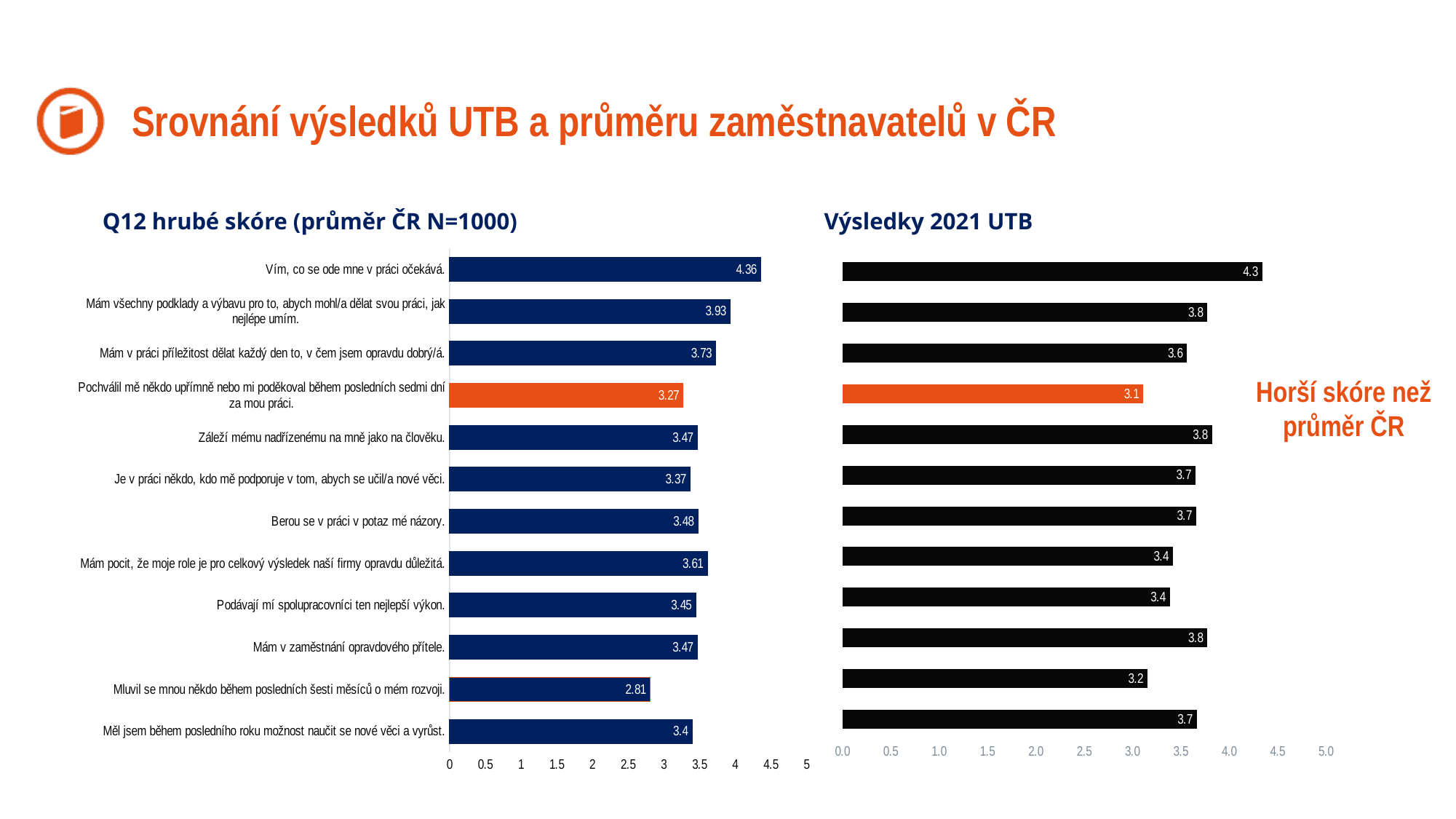
In the chart 'Výsledky 2021 UTB', what is the difference between the highest bar (4.3) and the lowest bar (3.1)? 1.2 In the chart 'Q12 hrubé skóre (průměr ČR N=1000)', which category has the lowest value? Mluvil se mnou někdo během posledních šesti měsíců o mém rozvoji. How many bars does the chart 'Q12 hrubé skóre (průměr ČR N=1000)' have? 12 In the chart 'Q12 hrubé skóre (průměr ČR N=1000)', what is the difference between 'Vím, co se ode mne v práci očekává.' and 'Mám všechny podklady a výbavu pro to, abych mohl/a dělat svou práci, jak nejlépe umím.'? 0.43 In the chart 'Q12 hrubé skóre (průměr ČR N=1000)', what is the value for 'Vím, co se ode mne v práci očekává.'? 4.36 In the chart 'Výsledky 2021 UTB', what is the value of the orange bar? 3.1 What type of chart is 'Výsledky 2021 UTB'? Bar chart In the chart 'Q12 hrubé skóre (průměr ČR N=1000)', which category has the highest value? Vím, co se ode mne v práci očekává. In the chart 'Q12 hrubé skóre (průměr ČR N=1000)', which is larger: 'Mám pocit, že moje role je pro celkový výsledek naší firmy opravdu důležitá.' or 'Berou se v práci v potaz mé názory.'? Mám pocit, že moje role je pro celkový výsledek naší firmy opravdu důležitá. In the chart 'Výsledky 2021 UTB', what is the value of the topmost bar? 4.3 In the chart 'Q12 hrubé skóre (průměr ČR N=1000)', what is the value for 'Pochválil mě někdo upřímně nebo mi poděkoval během posledních sedmi dní za mou práci.'? 3.27 In the chart 'Q12 hrubé skóre (průměr ČR N=1000)', what is the value for 'Mluvil se mnou někdo během posledních šesti měsíců o mém rozvoji.'? 2.81